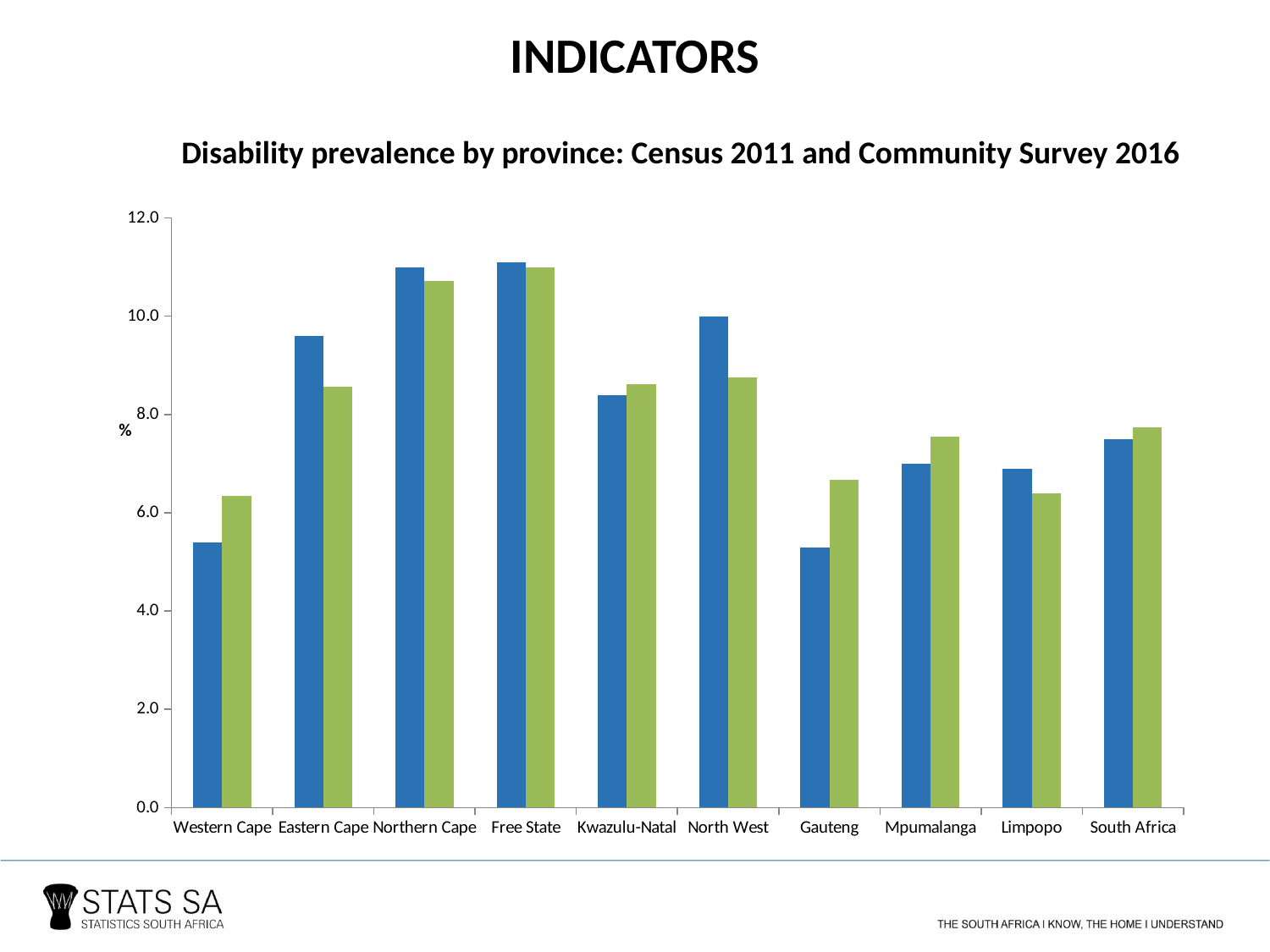
Is the value of the blue bar for Western Cape greater or less than 6.0? less Is the value of the blue bar for Eastern Cape greater or less than 8.0? greater How many provinces/categories are shown along the x axis of the chart? 10 What is the title of the chart? Disability prevalence by province: Census 2011 and Community Survey 2016 What kind of chart is shown on the slide? bar chart Is the value of the green bar for Gauteng greater or less than 6.0? greater For Eastern Cape, which bar is taller, the blue bar or the green bar? blue bar What label is shown on the vertical axis of the chart? % For Western Cape, which bar is taller, the blue bar or the green bar? green bar For North West, which bar is taller, the blue bar or the green bar? blue bar